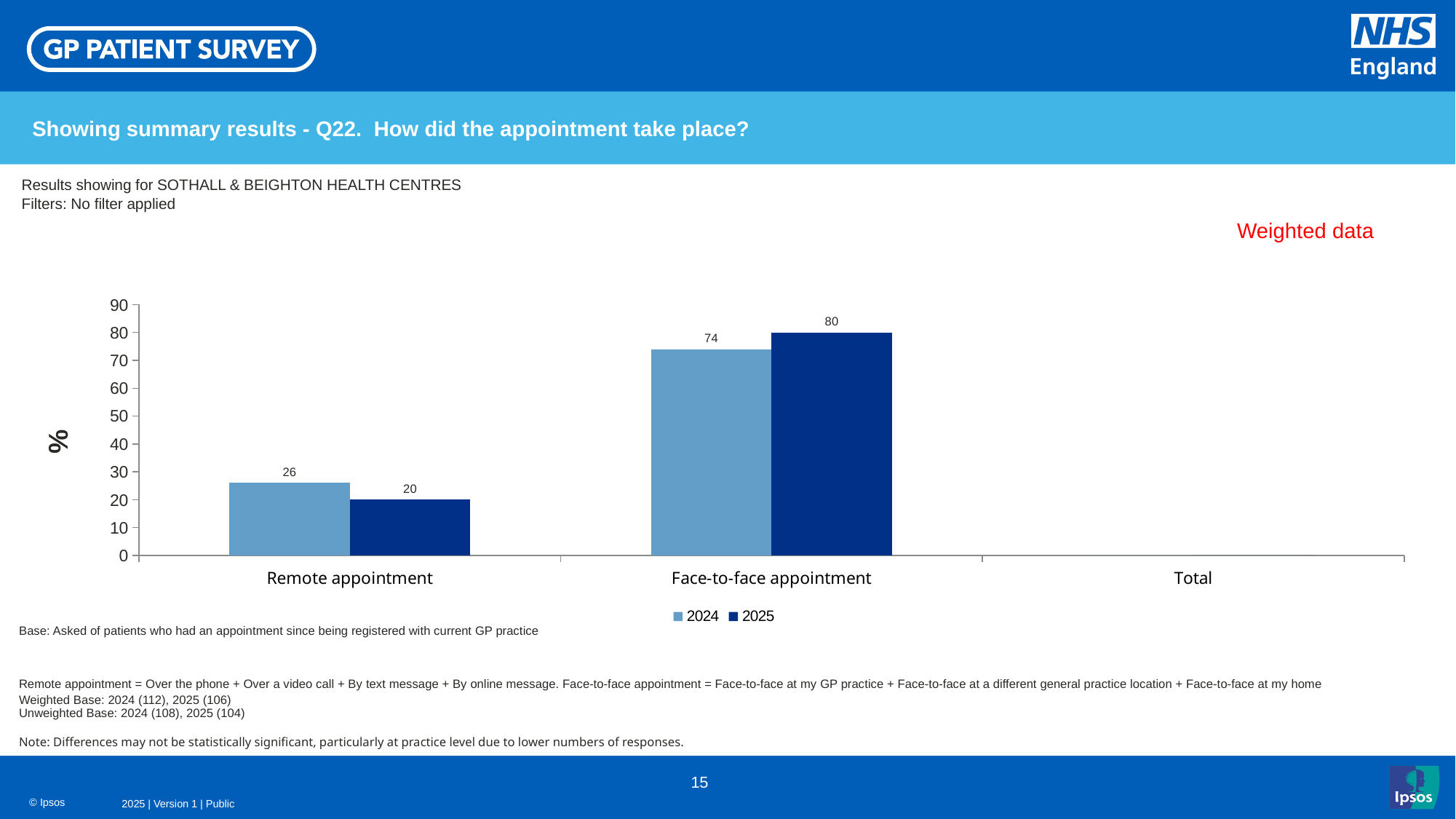
What label is shown on the vertical axis of the chart? % What kind of chart is shown on the slide? Bar chart What is the value for Face-to-face appointment in 2024? 74 How many series does the legend list? 2 What is the difference between the 2025 and 2024 values for Face-to-face appointment? 6 What is the difference between the 2024 and 2025 values for Remote appointment? 6 What is the value for Remote appointment in 2025? 20 Which is larger for Remote appointment: the 2024 value or the 2025 value? 2024 Which category has the lowest value in the 2024 series? Remote appointment Which category has the highest value in the 2025 series? Face-to-face appointment What is the value for Face-to-face appointment in 2025? 80 What is the value for Remote appointment in 2024? 26